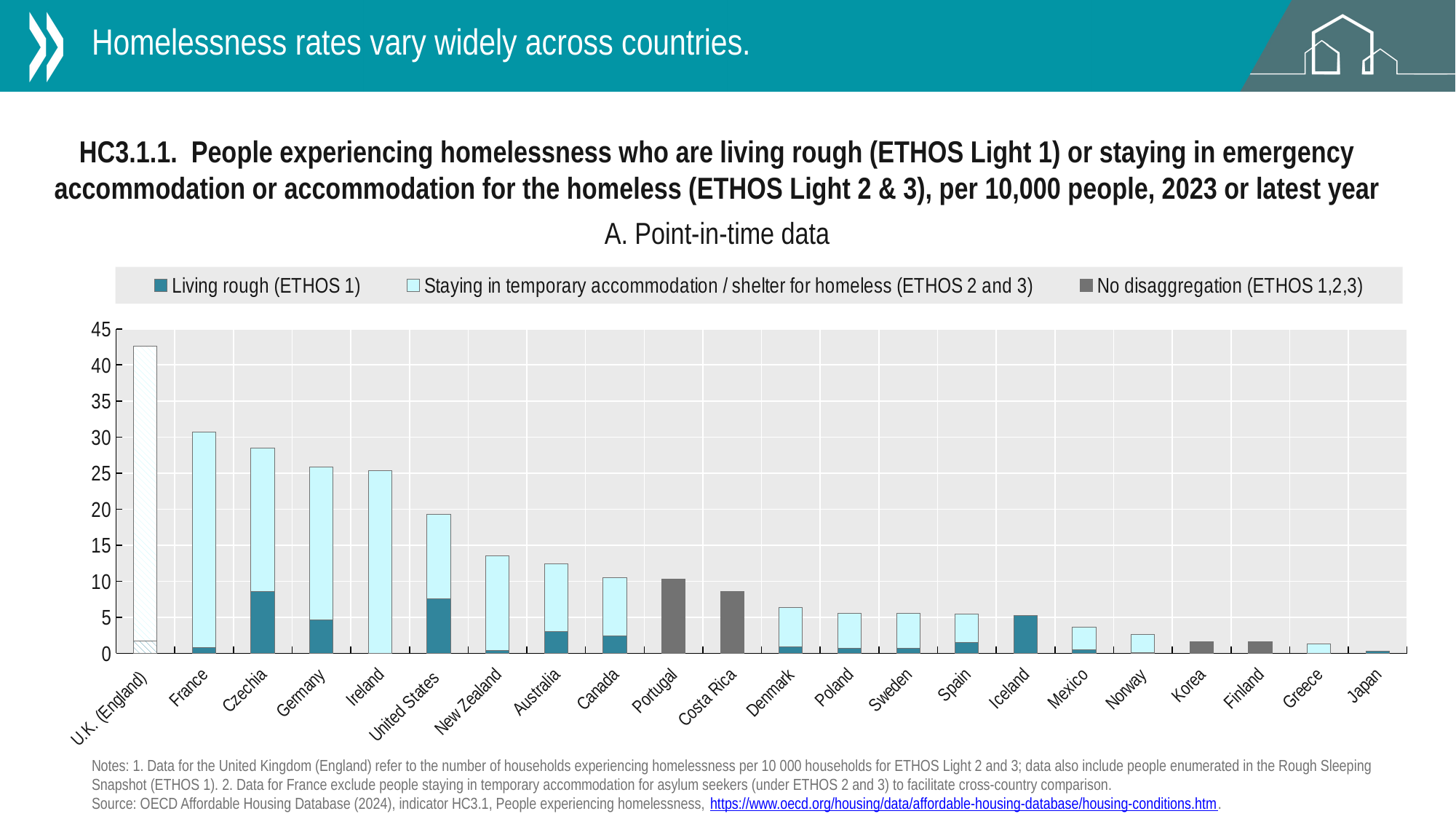
Is the total value for Costa Rica greater or less than 10? less Which country has the lowest total homelessness rate in the chart? Japan Which series in the legend is shown in dark grey? No disaggregation (ETHOS 1,2,3) What kind of chart is shown on the slide? Bar chart How many series does the chart's legend list? 3 Do the total values rise or fall moving from left to right along the x axis? Fall Is the total value for Mexico greater or less than 5? less Which has the larger total value, France or Czechia? France How many countries are shown on the x axis of the chart? 22 Is the total value for the United States greater or less than 20? less Which country has the highest total homelessness rate in the chart? U.K. (England)